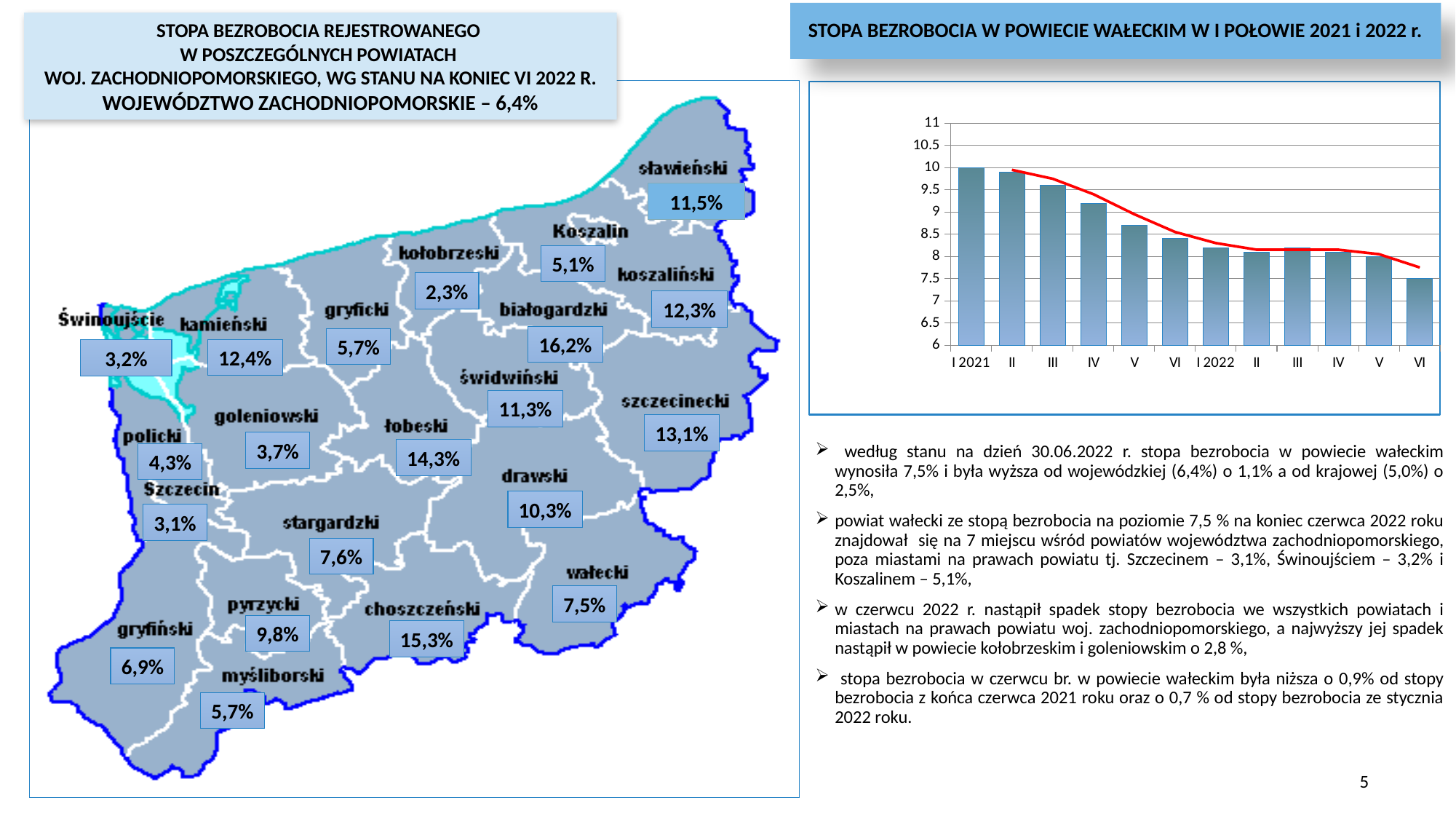
What kind of chart is shown on the right side of the slide under the title 'STOPA BEZROBOCIA W POWIECIE WAŁECKIM W I POŁOWIE 2021 i 2022 r.'? bar chart What is the title of the bar chart on the right side of the slide? STOPA BEZROBOCIA W POWIECIE WAŁECKIM W I POŁOWIE 2021 i 2022 r. In the bar chart on the right, how many bars (months) are plotted? 12 In the bar chart on the right, do the values generally rise or fall from I 2021 to VI 2022? fall In the bar chart on the right, is the value for I 2022 greater or less than 8.5? less In the bar chart on the right, is the value for IV 2021 greater or less than 9? greater In the bar chart on the right, what is the value for I 2021? 10 In the bar chart on the right, what is the value for VI 2022? 7.5 In the bar chart on the right, which month has the highest bar? I 2021 In the bar chart on the right, which month has the lowest bar? VI (2022) In the bar chart on the right, is the value for II 2021 greater or less than 9.5? greater In the bar chart on the right, which is larger: the value for I 2021 or the value for VI 2022? I 2021